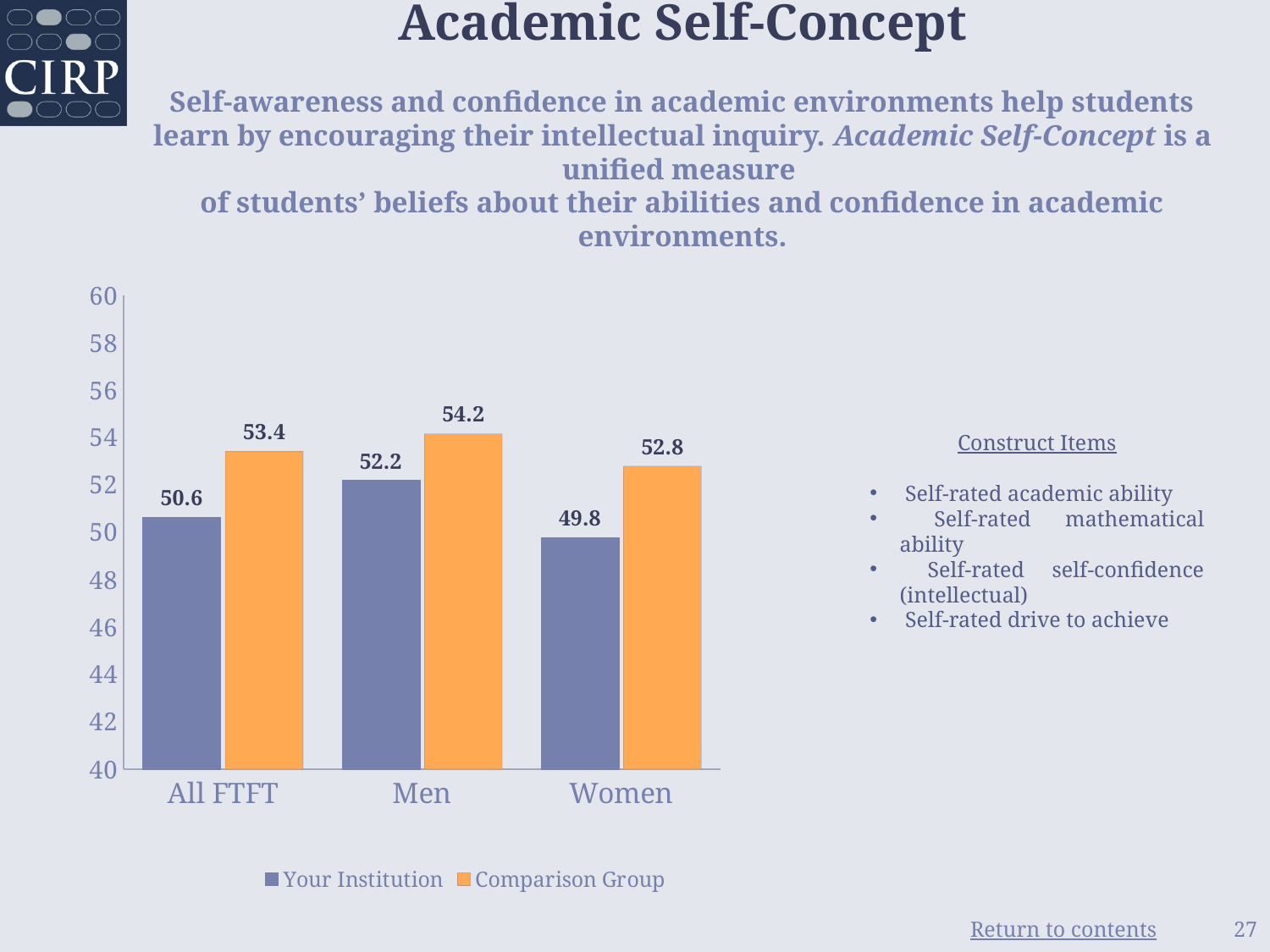
How many series does the legend list? 2 Which category has the highest value for the Comparison Group? Men What is the difference between the Comparison Group and Your Institution values in the Women category? 3.0 How many categories are shown on the x axis? 3 Which category has the lowest value for Your Institution? Women What is the difference between the Men and Women values for Your Institution? 2.4 What kind of chart is shown on the slide? Bar chart What is the value for Your Institution in the All FTFT category? 50.6 What is the value for the Comparison Group in the Men category? 54.2 What is the value for Your Institution in the Women category? 49.8 Is the value for Your Institution in the Men category greater or less than 50? greater In the All FTFT category, which is larger: Your Institution or the Comparison Group? Comparison Group